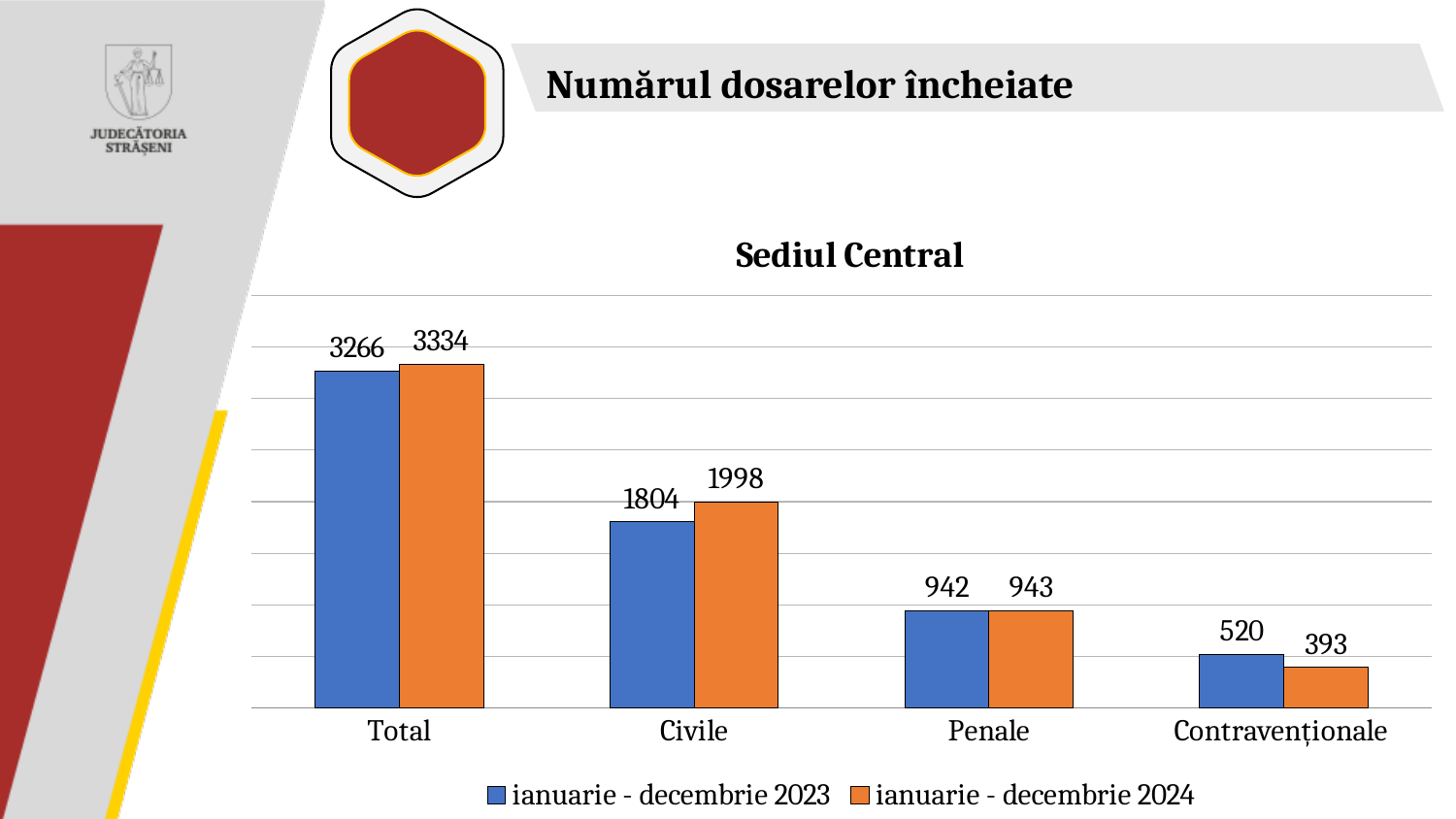
What is the difference between the ianuarie - decembrie 2024 and ianuarie - decembrie 2023 values for Civile? 194 Which category has the highest value in the ianuarie - decembrie 2023 series? Total What kind of chart is shown on the slide? bar chart What is the difference between the ianuarie - decembrie 2023 and ianuarie - decembrie 2024 values for Contravenționale? 127 Which category has the lowest value in the ianuarie - decembrie 2024 series? Contravenționale How many categories are shown on the x axis? 4 What is the value for Contravenționale in the ianuarie - decembrie 2023 series? 520 How many series does the legend list? 2 What is the title of the chart? Sediul Central For Total, which series has the larger value: ianuarie - decembrie 2023 or ianuarie - decembrie 2024? ianuarie - decembrie 2024 What is the value for Civile in the ianuarie - decembrie 2024 series? 1998 What is the value for Penale in the ianuarie - decembrie 2024 series? 943